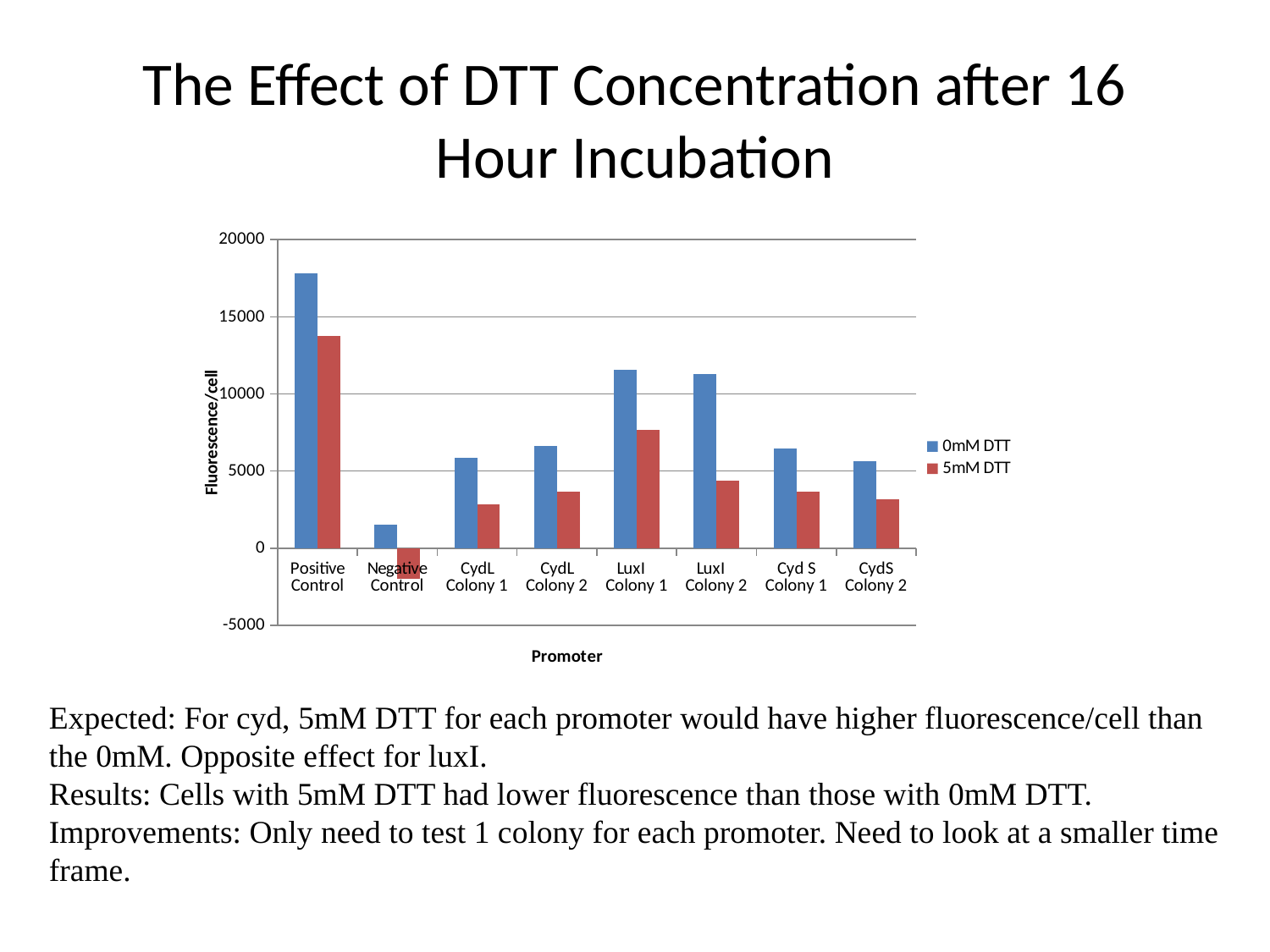
How many series does the legend list? 2 Which is larger, the 5mM DTT value for LuxI Colony 1 or for LuxI Colony 2? LuxI Colony 1 Which category has the highest 0mM DTT value? Positive Control Which category has the lowest 5mM DTT value? Negative Control What kind of chart is shown on the slide? bar chart Is the 0mM DTT value for LuxI Colony 1 greater or less than 10000? greater Is the 5mM DTT value for CydL Colony 1 greater or less than 5000? less For Positive Control, which series has the larger value, 0mM DTT or 5mM DTT? 0mM DTT Is the 0mM DTT value for Positive Control greater or less than 15000? greater What is the title of the y axis? Fluorescence/cell How many promoter categories are shown on the x axis? 8